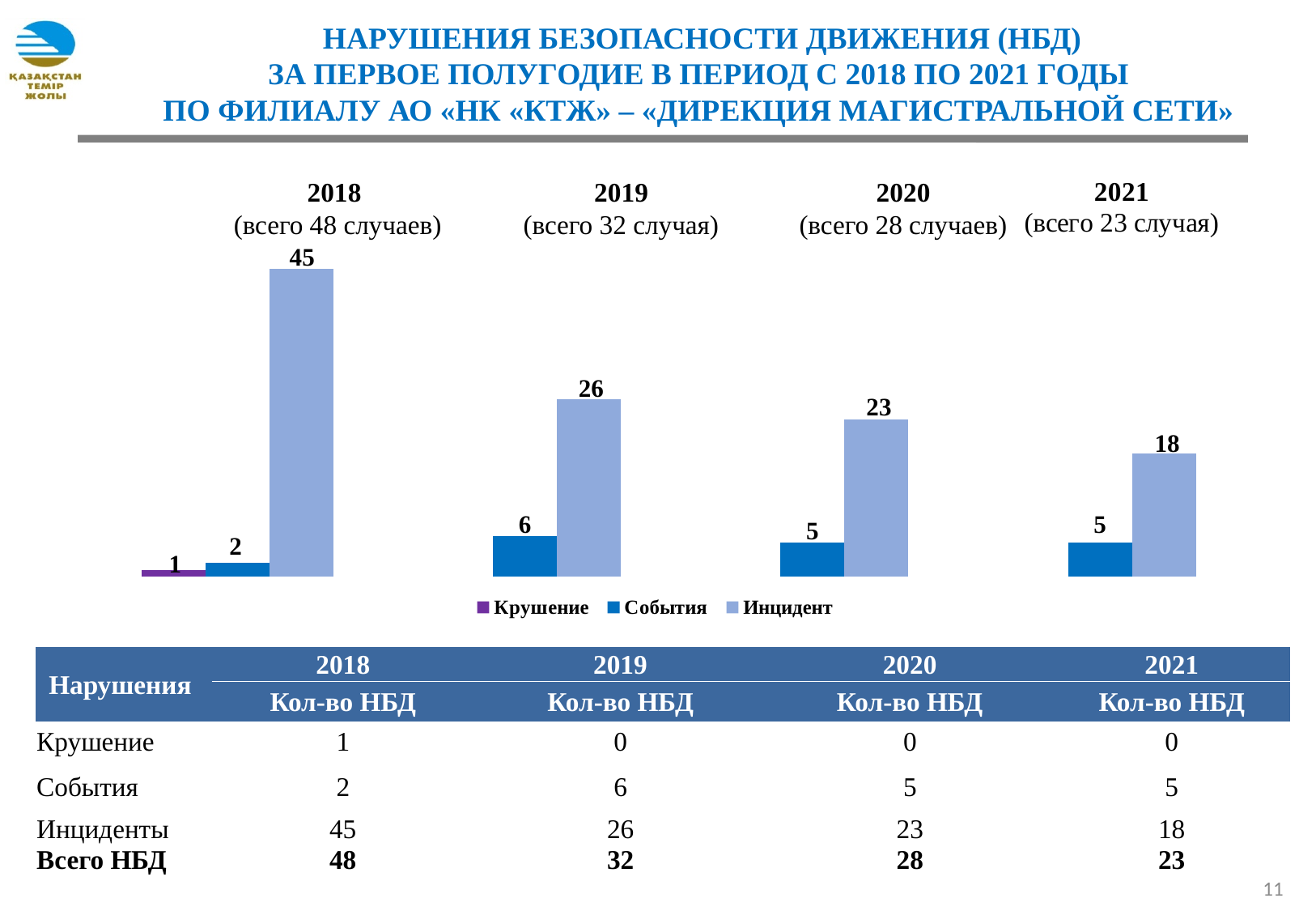
What is the difference between the Инцидент values for 2018 and 2019? 19 How many series does the legend list? 3 Which year has the lowest value for Инцидент? 2021 What is the value of Инцидент for 2018? 45 Which year has the highest value for Инцидент? 2018 Do the Инцидент values rise or fall from 2018 to 2021? fall What kind of chart is shown on the slide? bar chart What is the value of Инцидент for 2021? 18 What is the value of Крушение for 2018? 1 What is the value of События for 2019? 6 How many years are shown on the x axis of the chart? 4 Which is larger, the События value for 2019 or for 2020? 2019